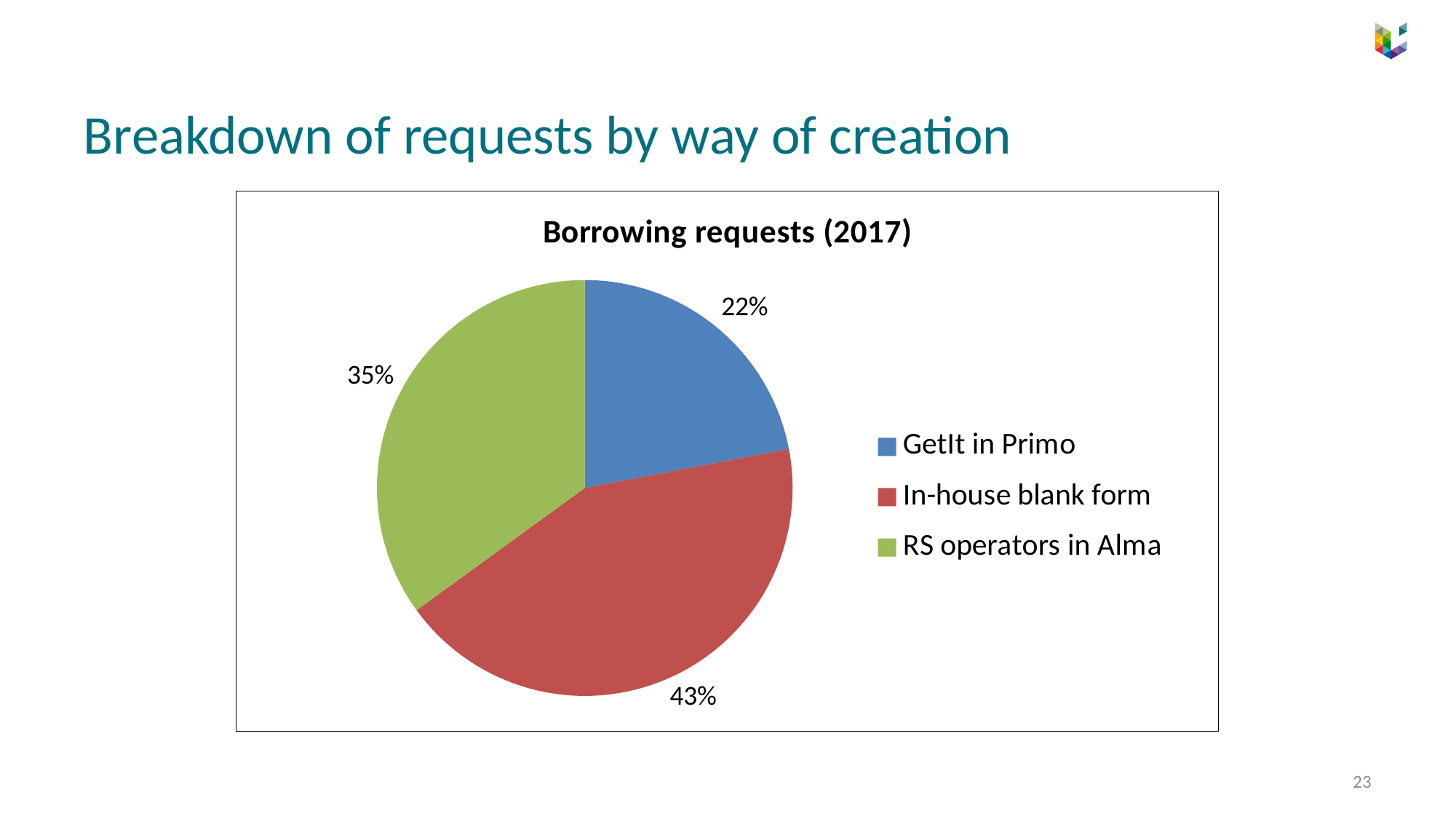
How many slices does the pie chart have? 3 What share of borrowing requests came from GetIt in Primo? 22% Which way of creation accounts for the largest share of borrowing requests? In-house blank form What type of chart is shown on the slide? pie chart What is the difference in percentage points between In-house blank form and GetIt in Primo? 21 What share of borrowing requests came from In-house blank form? 43% What is the title of the chart? Borrowing requests (2017) What colour is the slice for RS operators in Alma? green What share of borrowing requests came from RS operators in Alma? 35% How many entries does the legend list? 3 Which is larger: the share for RS operators in Alma or the share for GetIt in Primo? RS operators in Alma Which way of creation accounts for the smallest share of borrowing requests? GetIt in Primo